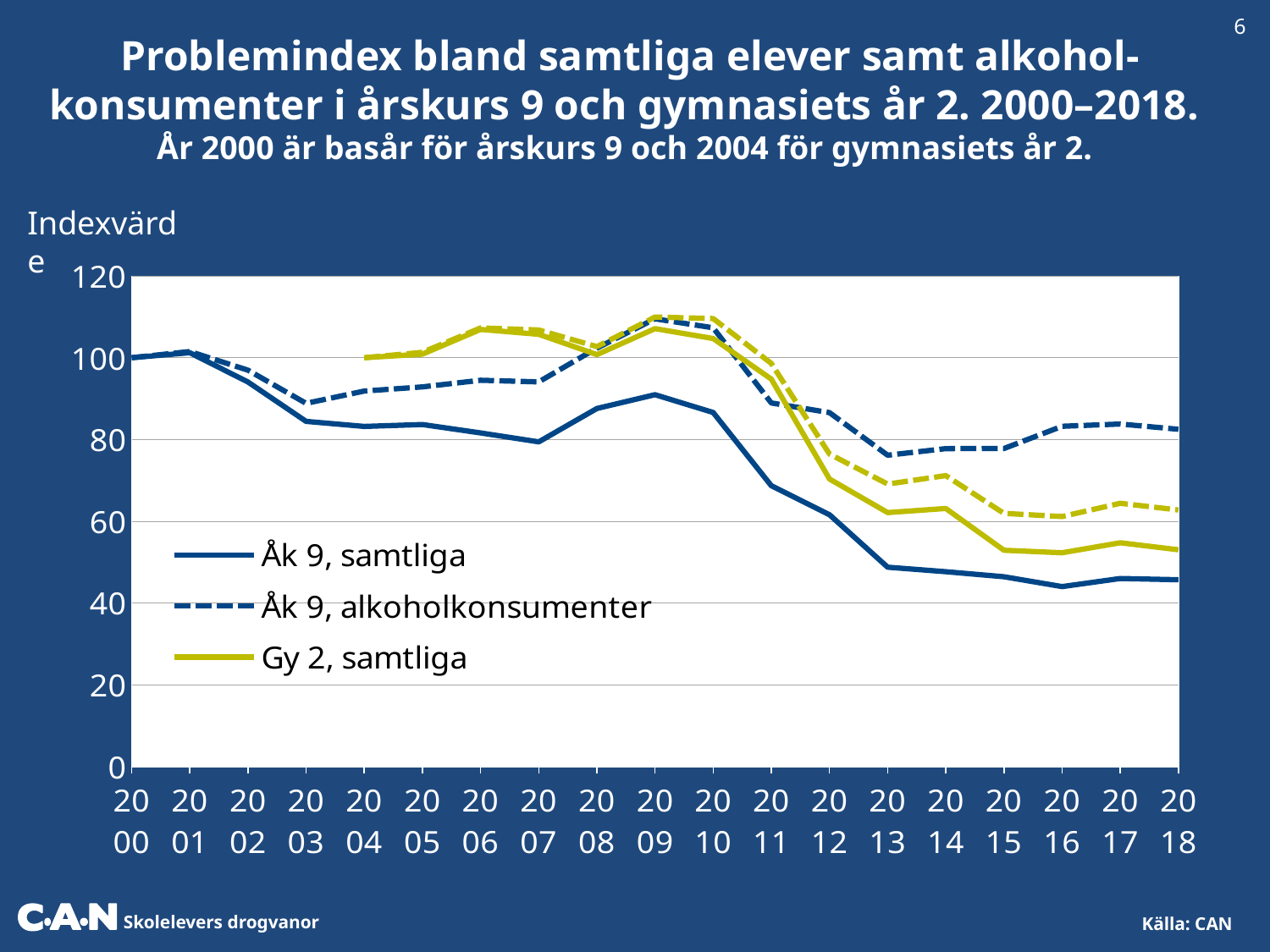
Is the value for Gy 2, samtliga in 2015 greater or less than 60? less Does the Åk 9, samtliga line rise or fall between 2010 and 2013? fall How many series does the chart legend list? 3 Is the value for Åk 9, samtliga in 2009 greater or less than 80? greater In 2018, which is larger: Åk 9, samtliga or Åk 9, alkoholkonsumenter? Åk 9, alkoholkonsumenter What is the index value for Gy 2, samtliga in its base year 2004? 100 What kind of chart is shown on the slide? line chart Is the value for Åk 9, alkoholkonsumenter in 2018 greater or less than 80? greater What is the index value for Åk 9, samtliga in the base year 2000? 100 How many years are shown along the x axis? 19 What is the label on the y axis of the chart? Indexvärde